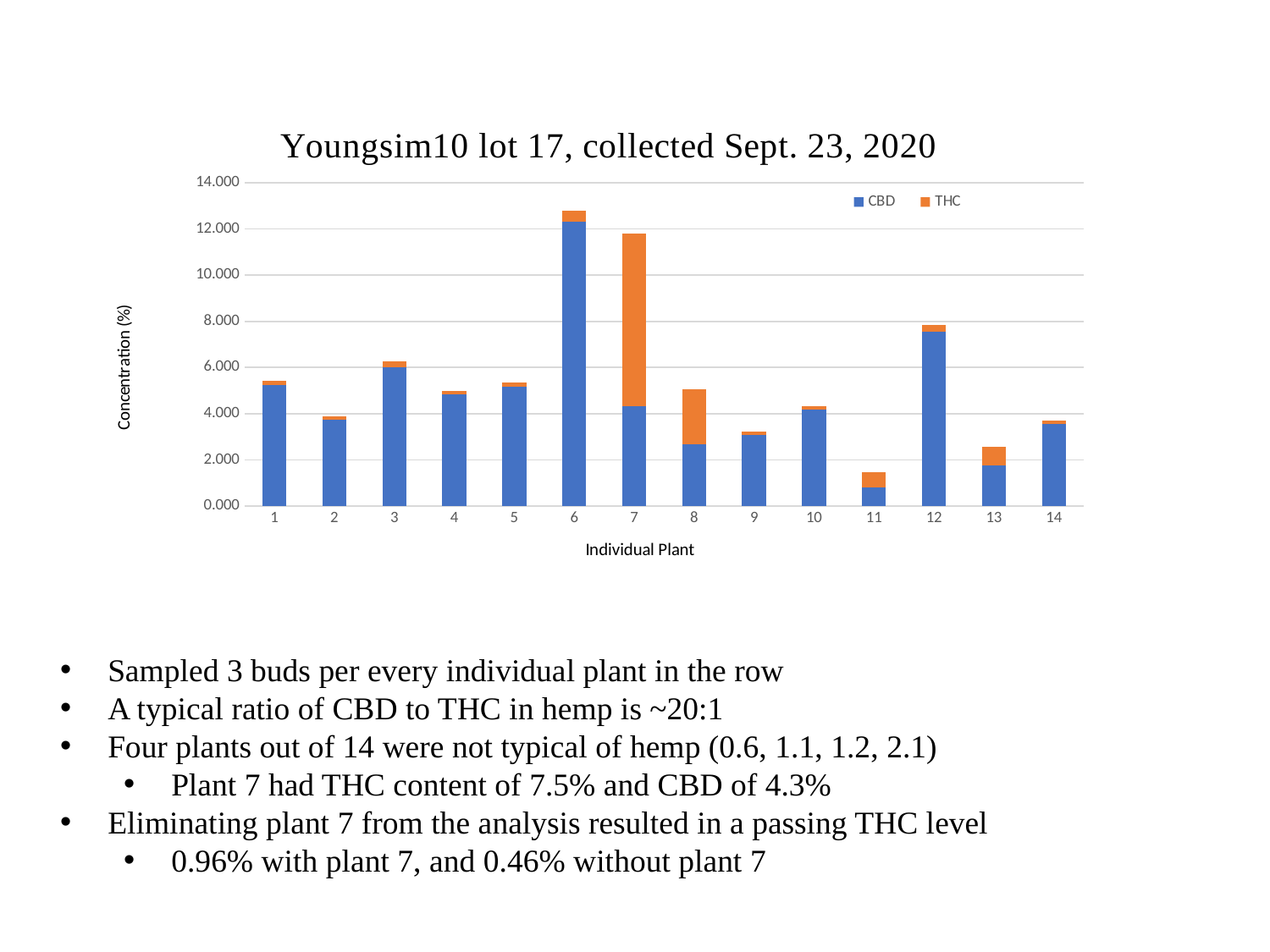
Which individual plant has the largest THC segment in the chart? 7 Which has a larger total concentration, plant 3 or plant 9? Plant 3 Which individual plant has the highest total concentration in the chart? 6 How many series does the chart legend list? 2 What kind of chart is shown on the slide? Stacked bar chart Is the total concentration for plant 11 greater or less than 2.000? less Is the total concentration for plant 6 greater or less than 12.000? greater Is the total concentration for plant 12 greater or less than 6.000? greater How many individual plants are shown on the x axis of the chart? 14 What is the title of the chart? Youngsim10 lot 17, collected Sept. 23, 2020 Which individual plant has the lowest total concentration in the chart? 11 Which individual plant has the highest CBD value in the chart? 6